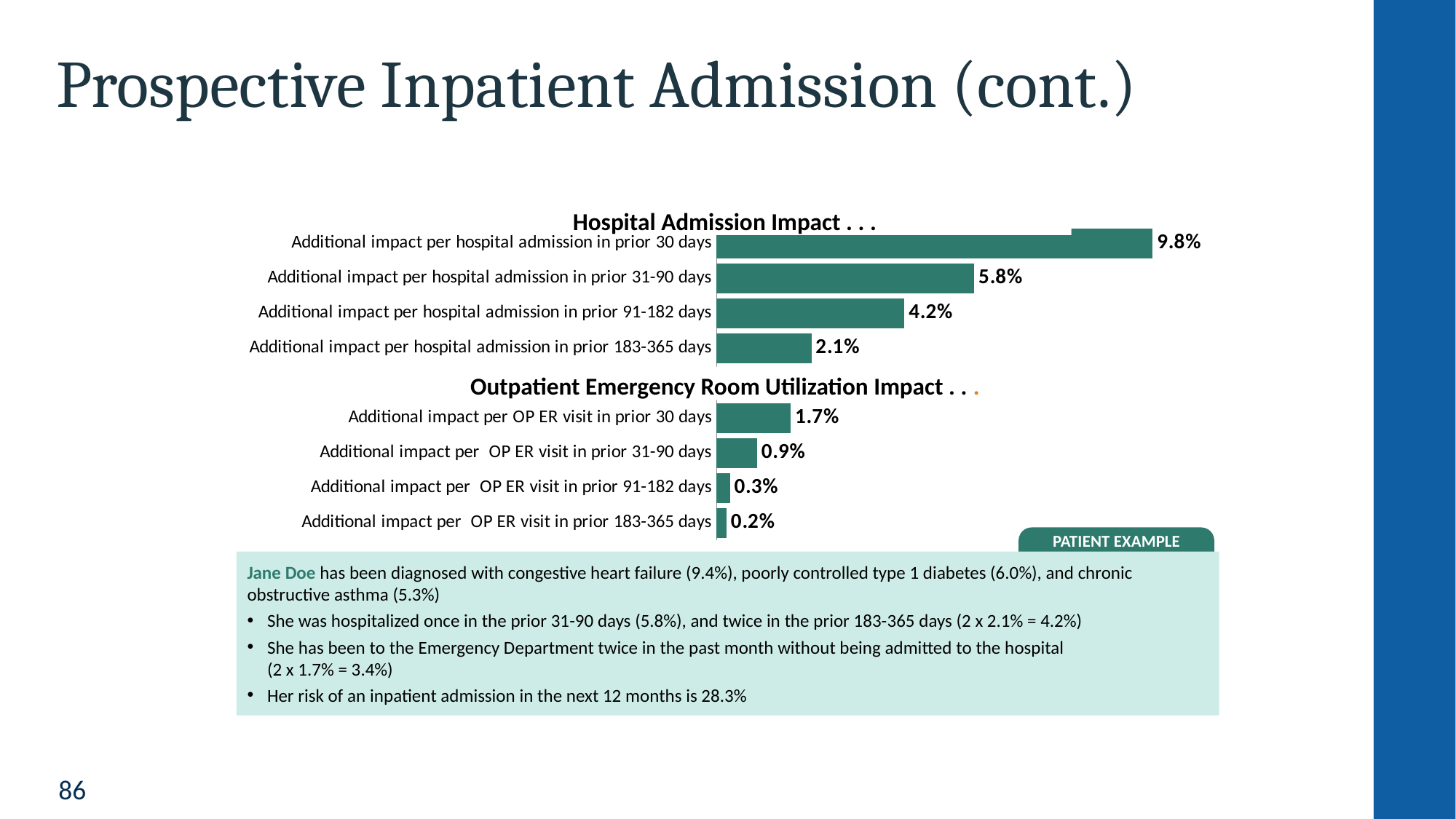
In the Outpatient Emergency Room Utilization Impact chart, which category has the lowest value? Additional impact per OP ER visit in prior 183-365 days What type of chart is the Outpatient Emergency Room Utilization Impact chart? Bar chart In the Outpatient Emergency Room Utilization Impact chart, what is the difference between the prior 30 days value and the prior 31-90 days value? 0.8% How many bars are shown in the Hospital Admission Impact chart? 4 In the Hospital Admission Impact chart, which category has the highest value? Additional impact per hospital admission in prior 30 days In the Hospital Admission Impact chart, what is the difference between the prior 31-90 days value and the prior 91-182 days value? 1.6% In the Outpatient Emergency Room Utilization Impact chart, what is the additional impact per OP ER visit in prior 30 days? 1.7% Which is larger: the Hospital Admission Impact value for prior 183-365 days or the Outpatient Emergency Room Utilization Impact value for prior 30 days? Hospital Admission Impact value for prior 183-365 days In the Outpatient Emergency Room Utilization Impact chart, what is the additional impact per OP ER visit in prior 91-182 days? 0.3% In the Hospital Admission Impact chart, do the values rise or fall as the prior-day window moves from 30 days to 183-365 days? Fall In the Hospital Admission Impact chart, what is the additional impact per hospital admission in prior 30 days? 9.8% In the Hospital Admission Impact chart, what is the additional impact per hospital admission in prior 183-365 days? 2.1%